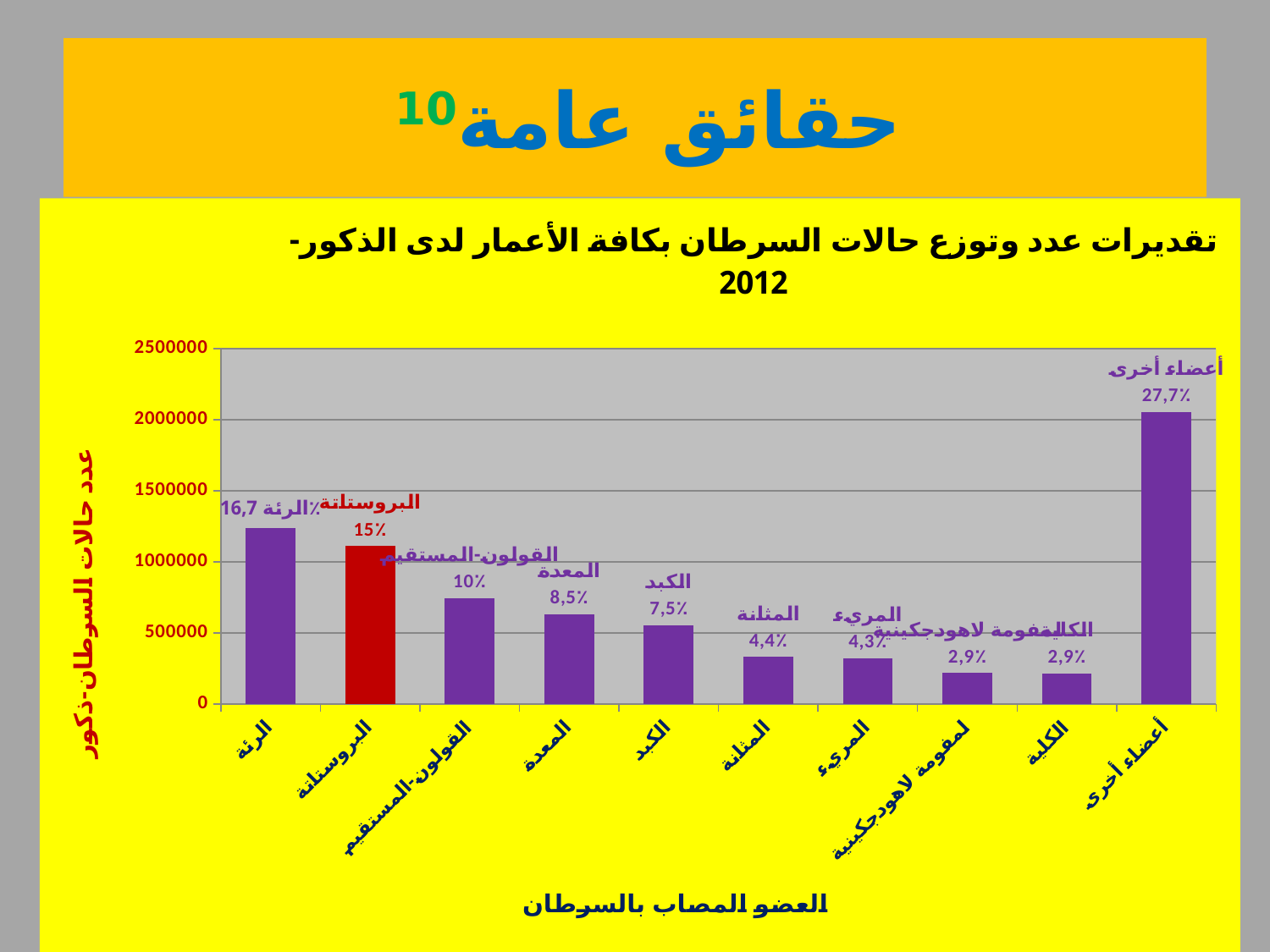
Is the value for الرئة greater or less than 1000000? greater Is the value for المثانة greater or less than 500000? less Which is larger, the bar for الرئة or the bar for البروستاتة? الرئة What percentage label is shown for الرئة? 16,7% What is the difference between the percentage labels for أعضاء أخرى and الرئة? 11% What percentage label is shown for البروستاتة? 15% How many categories (organs) are shown on the x axis of the chart? 10 Which category's bar is coloured red in the chart? البروستاتة What percentage label is shown for المعدة? 8,5% What percentage label is shown for أعضاء أخرى? 27,7% Which category has the highest bar in the chart? أعضاء أخرى What kind of chart is shown on the slide? bar chart